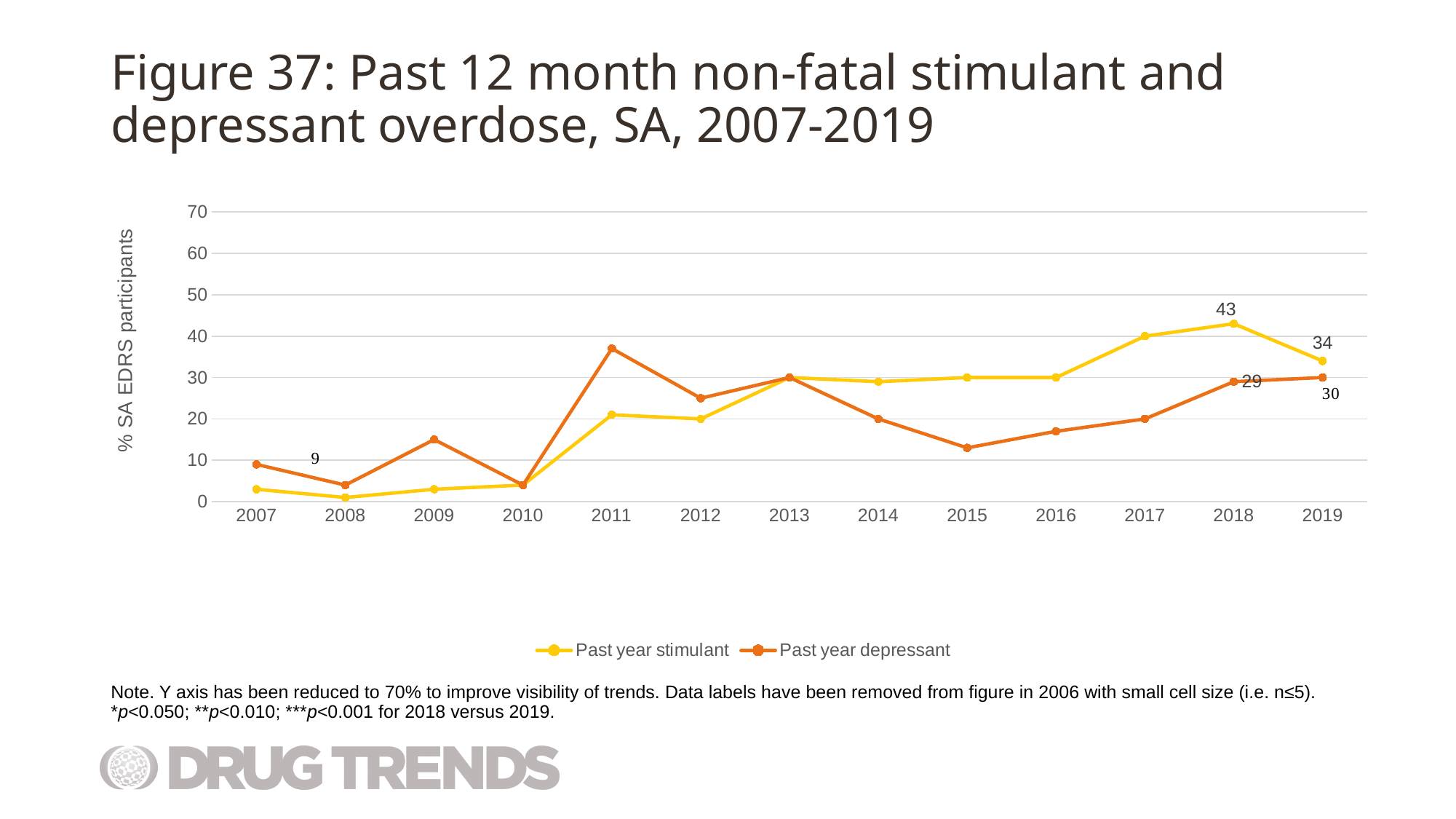
What is the value for Past year depressant in 2018? 29 In 2018, which series has the higher value, Past year stimulant or Past year depressant? Past year stimulant How many years are shown on the x axis? 13 In which year does the Past year stimulant series reach its highest value? 2018 How many series does the legend list? 2 Is the value for Past year depressant in 2011 greater or less than 30? greater By how much did the Past year stimulant value fall from 2018 to 2019? 9 What is the value for Past year stimulant in 2018? 43 What kind of chart is shown on the slide? line chart What is the value for Past year depressant in 2019? 30 What is the difference between the Past year stimulant and Past year depressant values in 2019? 4 What is the value for Past year stimulant in 2019? 34